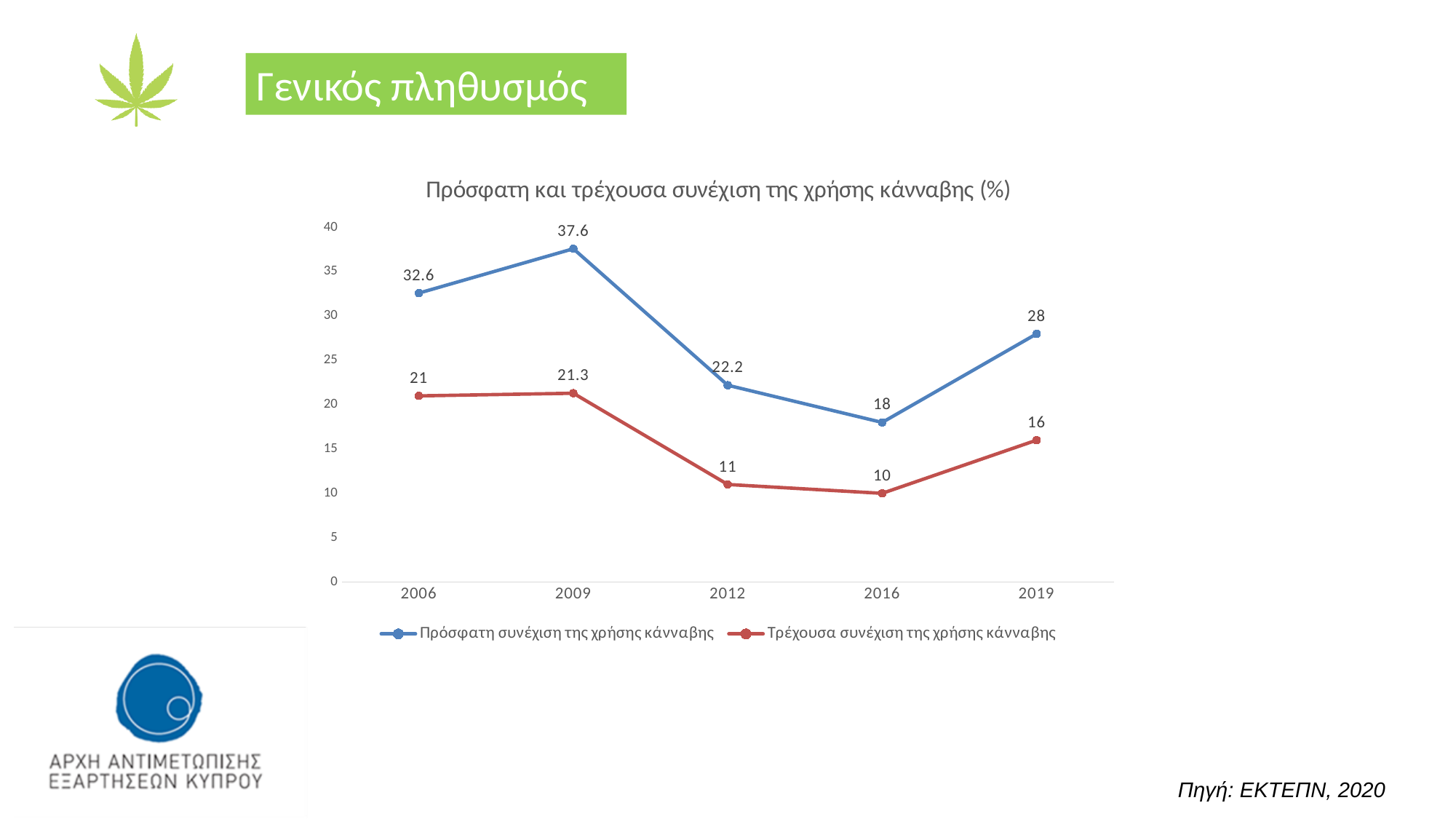
How many years are shown on the x axis? 5 Is the value for Πρόσφατη συνέχιση της χρήσης κάνναβης in 2016 greater or less than 20? less What is the value for Πρόσφατη συνέχιση της χρήσης κάνναβης in 2019? 28 In which year is Πρόσφατη συνέχιση της χρήσης κάνναβης highest? 2009 What is the value for Πρόσφατη συνέχιση της χρήσης κάνναβης in 2009? 37.6 What kind of chart is shown? line chart In which year is Τρέχουσα συνέχιση της χρήσης κάνναβης lowest? 2016 Which is larger in 2006: Πρόσφατη συνέχιση της χρήσης κάνναβης or Τρέχουσα συνέχιση της χρήσης κάνναβης? Πρόσφατη συνέχιση της χρήσης κάνναβης How many series does the legend list? 2 What is the value for Τρέχουσα συνέχιση της χρήσης κάνναβης in 2016? 10 What is the title of the chart? Πρόσφατη και τρέχουσα συνέχιση της χρήσης κάνναβης (%) What is the difference between Πρόσφατη and Τρέχουσα συνέχιση της χρήσης κάνναβης in 2012? 11.2